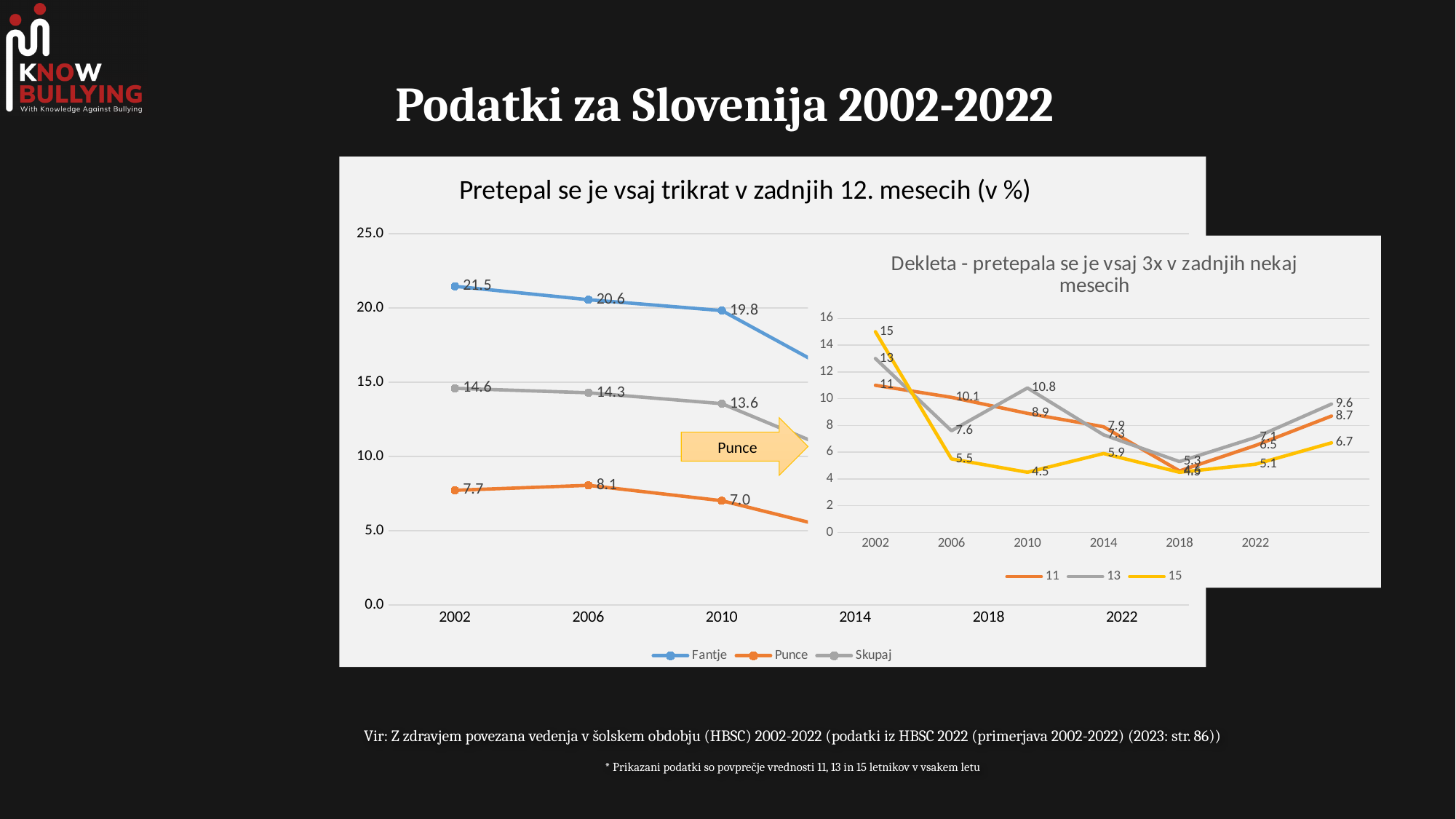
In the chart titled "Pretepal se je vsaj trikrat v zadnjih 12. mesecih (v %)", what is the difference between the Fantje and Punce values in 2002? 13.8 In the chart titled "Pretepal se je vsaj trikrat v zadnjih 12. mesecih (v %)", what is the value for Punce in 2006? 8.1 In the chart titled "Dekleta - pretepala se je vsaj 3x v zadnjih nekaj mesecih", is the value for the 11 series in 2006 larger or smaller than the value for the 13 series in 2006? larger In the chart titled "Dekleta - pretepala se je vsaj 3x v zadnjih nekaj mesecih", which series has the lowest value in 2006? 15 In the chart titled "Dekleta - pretepala se je vsaj 3x v zadnjih nekaj mesecih", what is the value for the 13 series in 2010? 10.8 In the chart titled "Pretepal se je vsaj trikrat v zadnjih 12. mesecih (v %)", what is the value for Skupaj in 2010? 13.6 In the chart titled "Dekleta - pretepala se je vsaj 3x v zadnjih nekaj mesecih", what is the value for the 15 series in 2002? 15 What kind of chart is the one titled "Dekleta - pretepala se je vsaj 3x v zadnjih nekaj mesecih"? line chart In the chart titled "Pretepal se je vsaj trikrat v zadnjih 12. mesecih (v %)", how many series does the legend list? 3 In the chart titled "Pretepal se je vsaj trikrat v zadnjih 12. mesecih (v %)", which series has the highest value in 2006? Fantje In the chart titled "Pretepal se je vsaj trikrat v zadnjih 12. mesecih (v %)", what is the value for Fantje in 2002? 21.5 In the chart titled "Pretepal se je vsaj trikrat v zadnjih 12. mesecih (v %)", does the Fantje series rise or fall from 2002 to 2010? fall